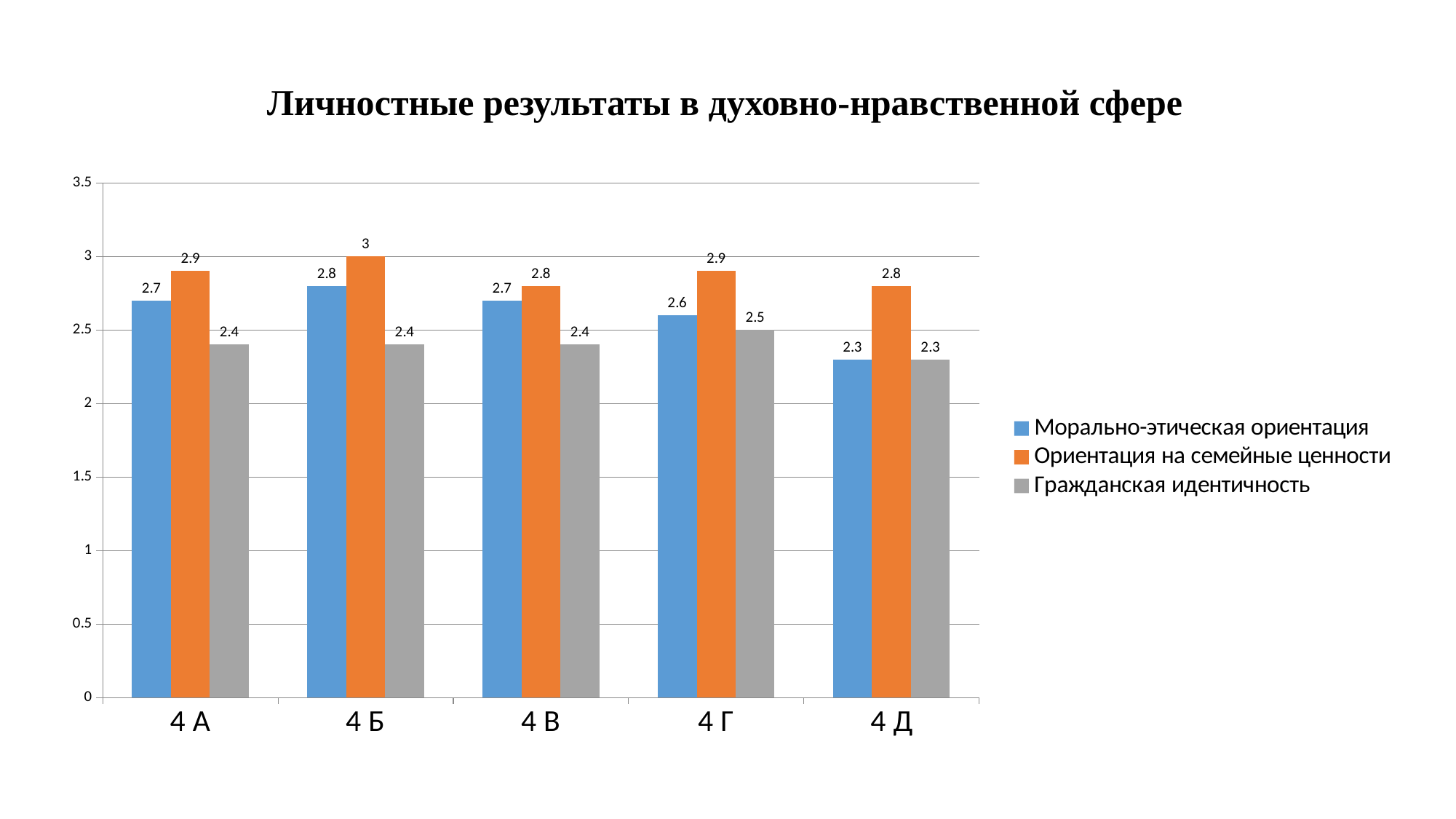
What is the value of Гражданская идентичность for 4 Д? 2.3 What is the difference between Ориентация на семейные ценности and Гражданская идентичность for 4 Б? 0.6 Which class has the highest value for Ориентация на семейные ценности? 4 Б How many classes are shown on the x axis? 5 Which is larger for 4 Г: Морально-этическая ориентация or Гражданская идентичность? Морально-этическая ориентация Which class has the lowest value for Морально-этическая ориентация? 4 Д What kind of chart is shown on the slide? Bar chart What is the value of Морально-этическая ориентация for 4 Б? 2.8 Is the value of Ориентация на семейные ценности for 4 А greater or less than 2.5? greater What is the title of the chart? Личностные результаты в духовно-нравственной сфере What is the value of Ориентация на семейные ценности for 4 Г? 2.9 How many series does the legend list? 3